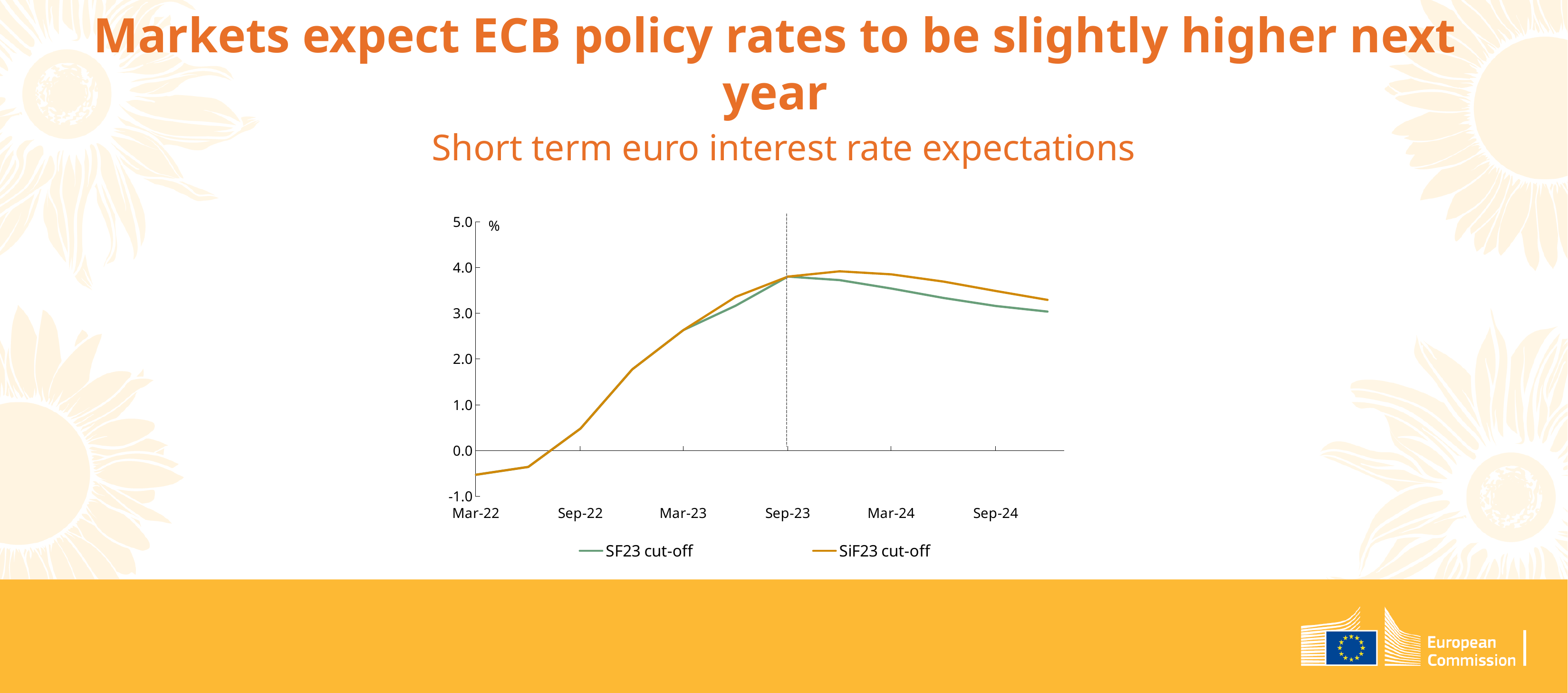
Do the interest rate expectations rise or fall between Mar-22 and Sep-23? rise At Sep-24, which series shows the higher value, SF23 cut-off or SiF23 cut-off? SiF23 cut-off What are the two series named in the legend? SF23 cut-off and SiF23 cut-off Is the SiF23 cut-off value at Sep-24 greater or less than 3.0? greater What is the chart's subtitle describing the data plotted? Short term euro interest rate expectations How many labelled tick marks are on the x axis? 6 What kind of chart is shown on the slide? line chart Is the value at Sep-23 greater or less than 3.0? greater Is the value at Mar-22 greater or less than 0.0? less Do the SF23 cut-off values rise or fall between Sep-23 and Sep-24? fall How many series does the legend list? 2